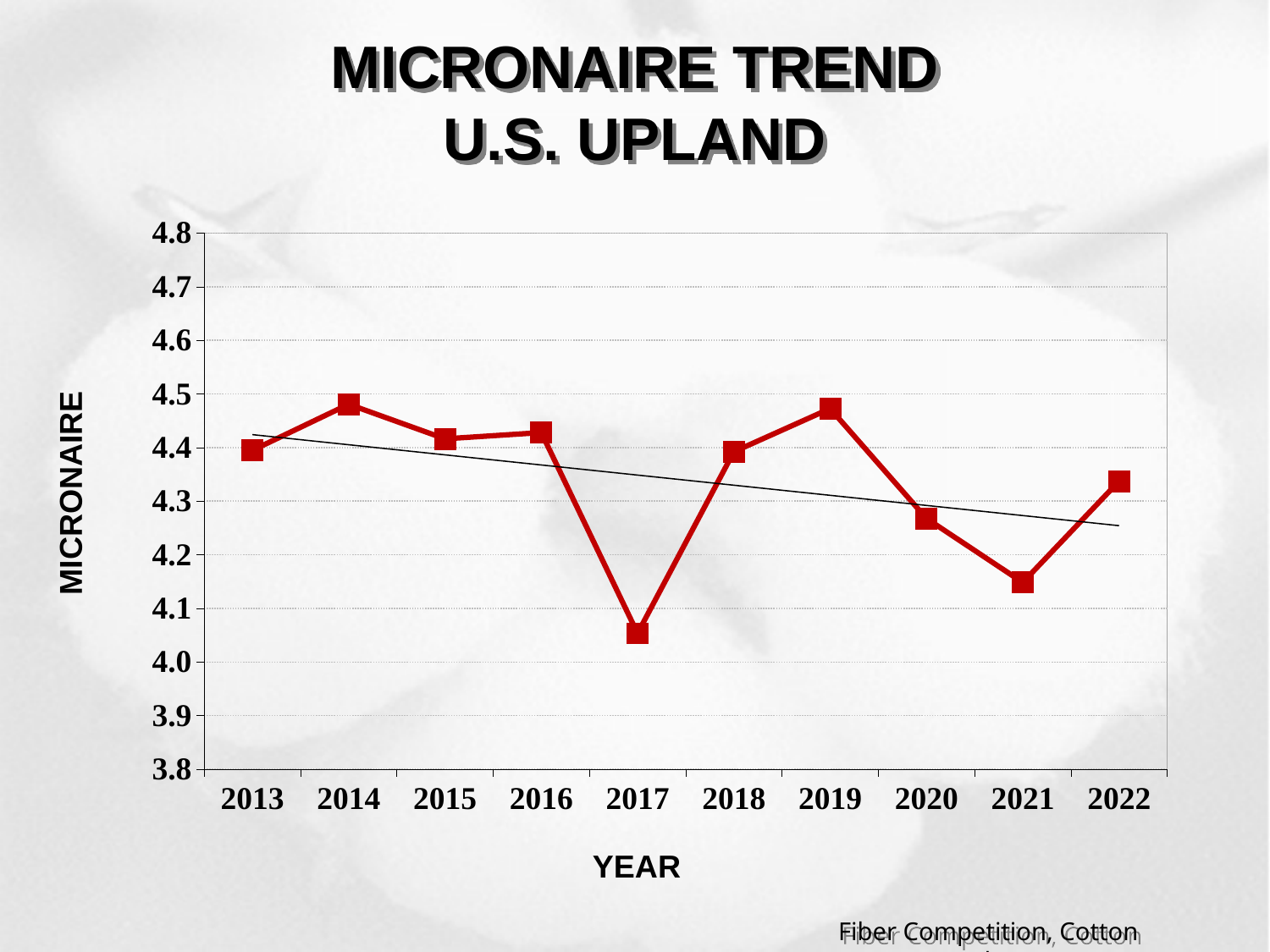
Which year has the higher micronaire value, 2017 or 2018? 2018 What is the label on the vertical axis? MICRONAIRE Is the micronaire value for 2014 greater or less than 4.4? greater Is the micronaire value for 2019 greater or less than 4.4? greater Is the micronaire value for 2020 greater or less than 4.3? less Which year has the higher micronaire value, 2021 or 2022? 2022 Which year has the lowest micronaire value? 2017 How many years are plotted on the x axis? 10 What kind of chart is shown on the slide? line chart According to the trend line, do micronaire values rise or fall from 2013 to 2022? fall